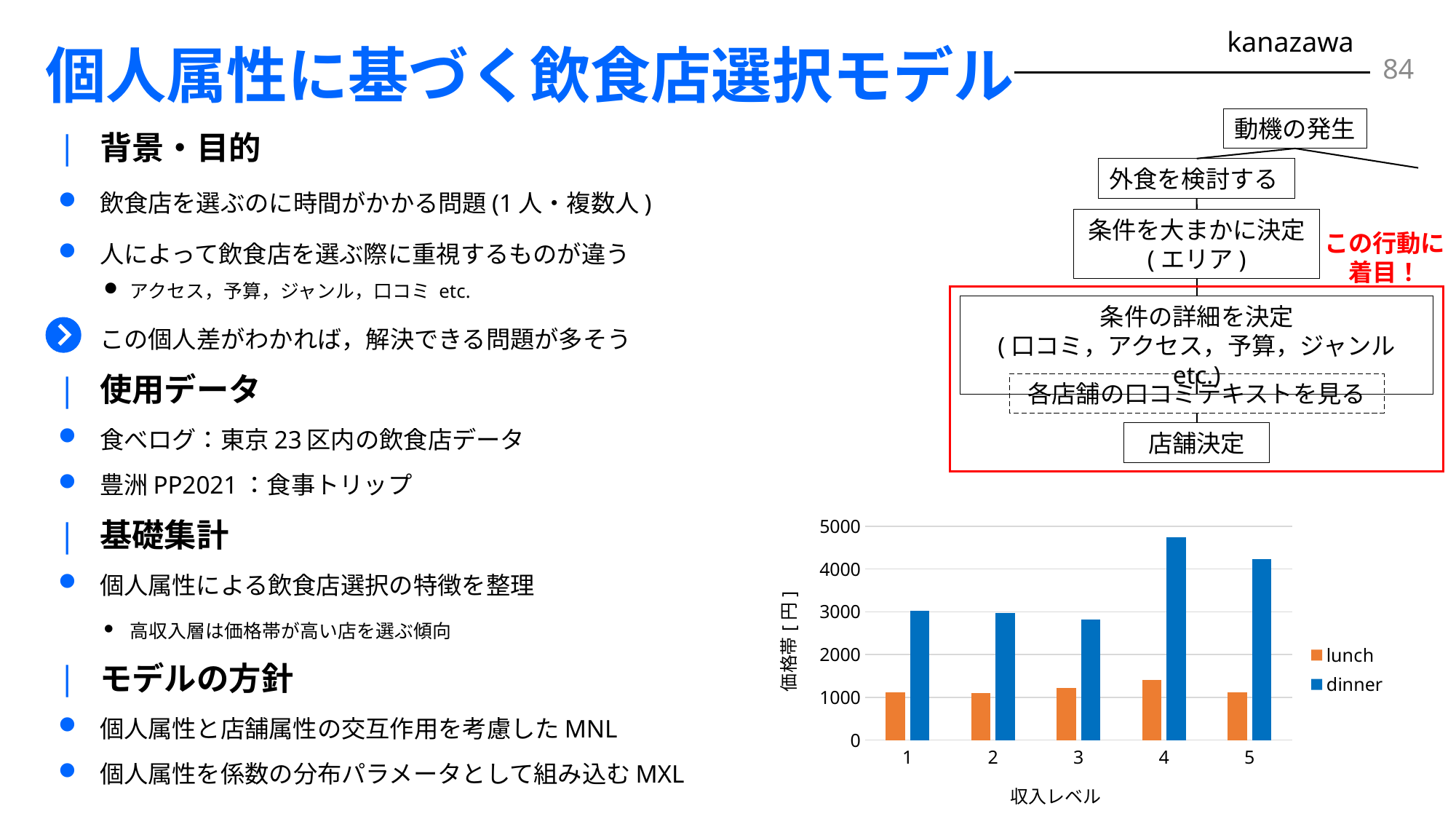
Is the dinner value for income level 4 greater or less than 4000? greater At income level 1, which is larger in the bar chart: lunch or dinner? dinner What is the label of the y axis of the bar chart? 価格帯 [円] What kind of chart is shown at the bottom right of the slide? bar chart At which income level is the dinner value highest in the bar chart? 4 How many series does the legend of the bar chart list? 2 Is the dinner value for income level 5 greater or less than 4000? greater Is the lunch value for income level 4 greater or less than 1000? greater What are the two series named in the legend of the bar chart? lunch, dinner How many income levels (収入レベル) are shown on the x axis of the bar chart? 5